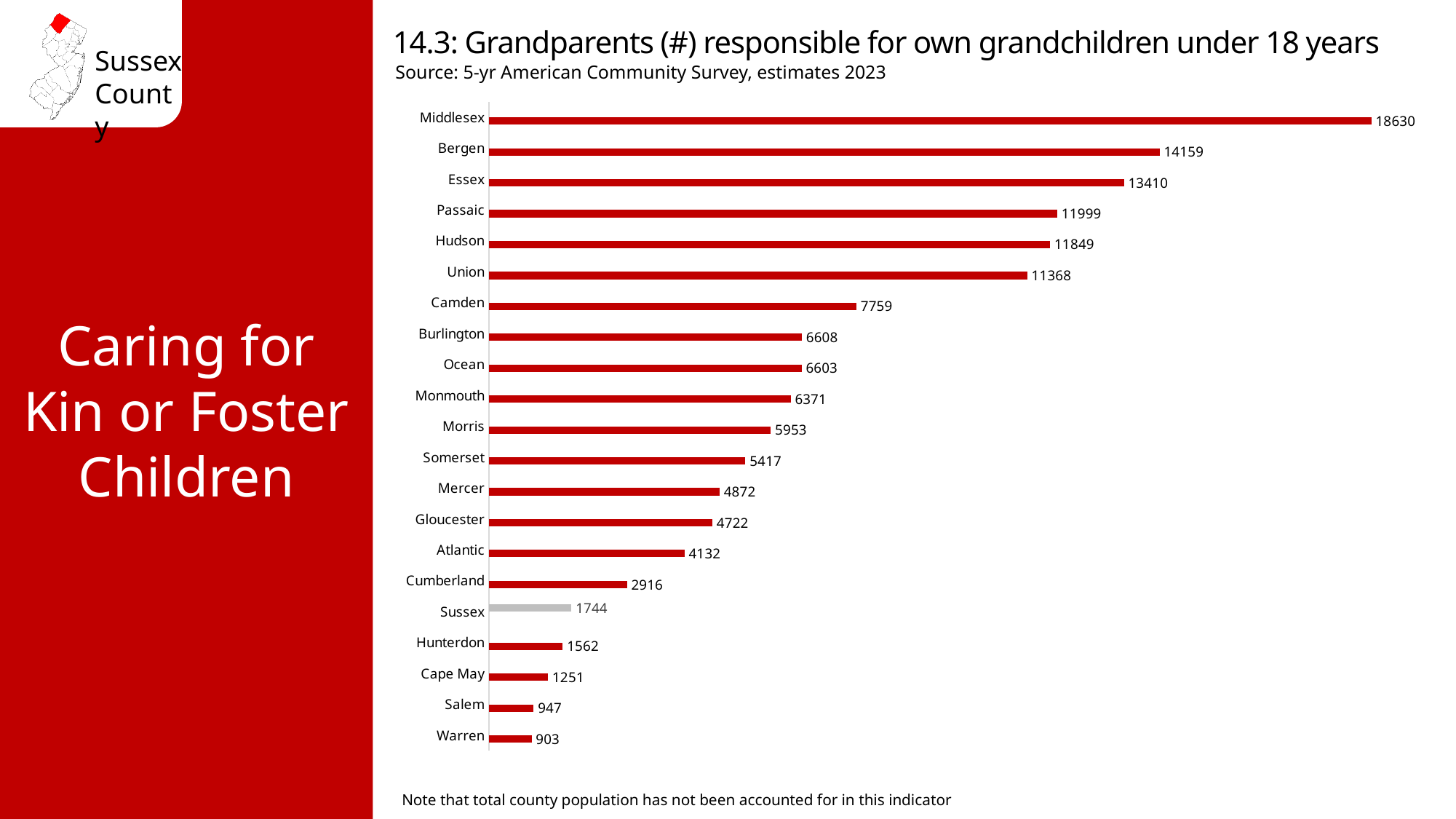
What is the value for Camden? 7759 Which county has the highest value? Middlesex Which county's bar is shown in grey rather than red? Sussex Which county has the lowest value? Warren What is the value for Sussex? 1744 Which is larger, the value for Passaic or the value for Union? Passaic What is the value for Middlesex? 18630 What is the difference between the values for Sussex and Hunterdon? 182 What kind of chart is this? Bar chart How many counties are shown in the chart? 21 Which is larger, the value for Cumberland or the value for Atlantic? Atlantic What is the difference between the values for Middlesex and Bergen? 4471